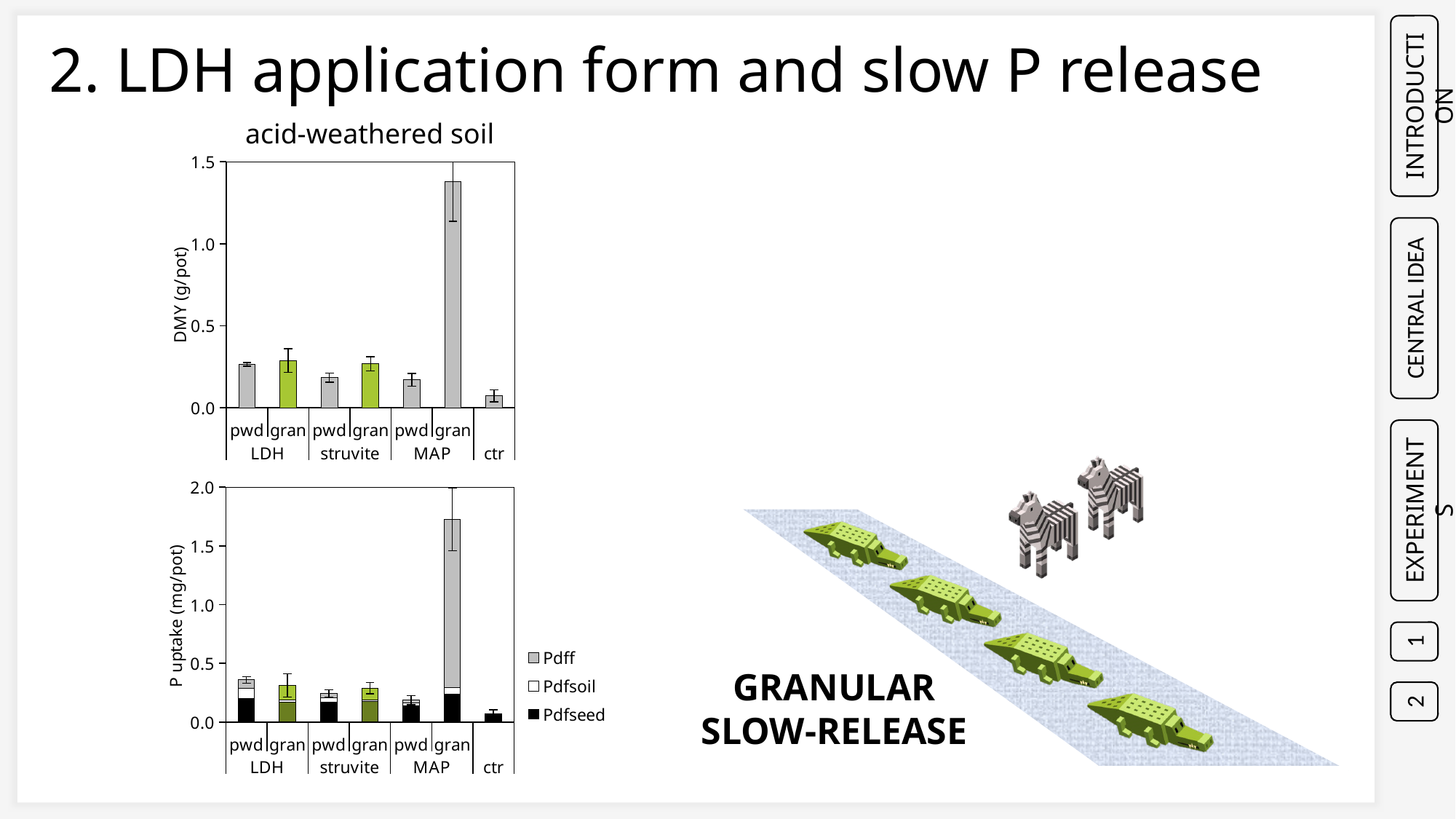
In the top chart (DMY), which bar is the lowest? ctr In the bottom chart (P uptake), is the total for MAP gran greater or less than 1.5? greater What kind of chart is the top chart titled "acid-weathered soil"? bar chart In the bottom chart (P uptake), which bar has the highest total? MAP gran In the top chart (DMY), how many bars are plotted? 7 What is the y-axis label of the bottom chart? P uptake (mg/pot) In the top chart (DMY), which bar is the highest? MAP gran In the top chart (DMY), is the value for ctr greater or less than 0.5? less In the bottom chart (P uptake), is the total for LDH pwd greater or less than 0.5? less How many series does the legend of the bottom chart (P uptake) list? 3 In the top chart (DMY), which is larger, MAP gran or struvite pwd? MAP gran